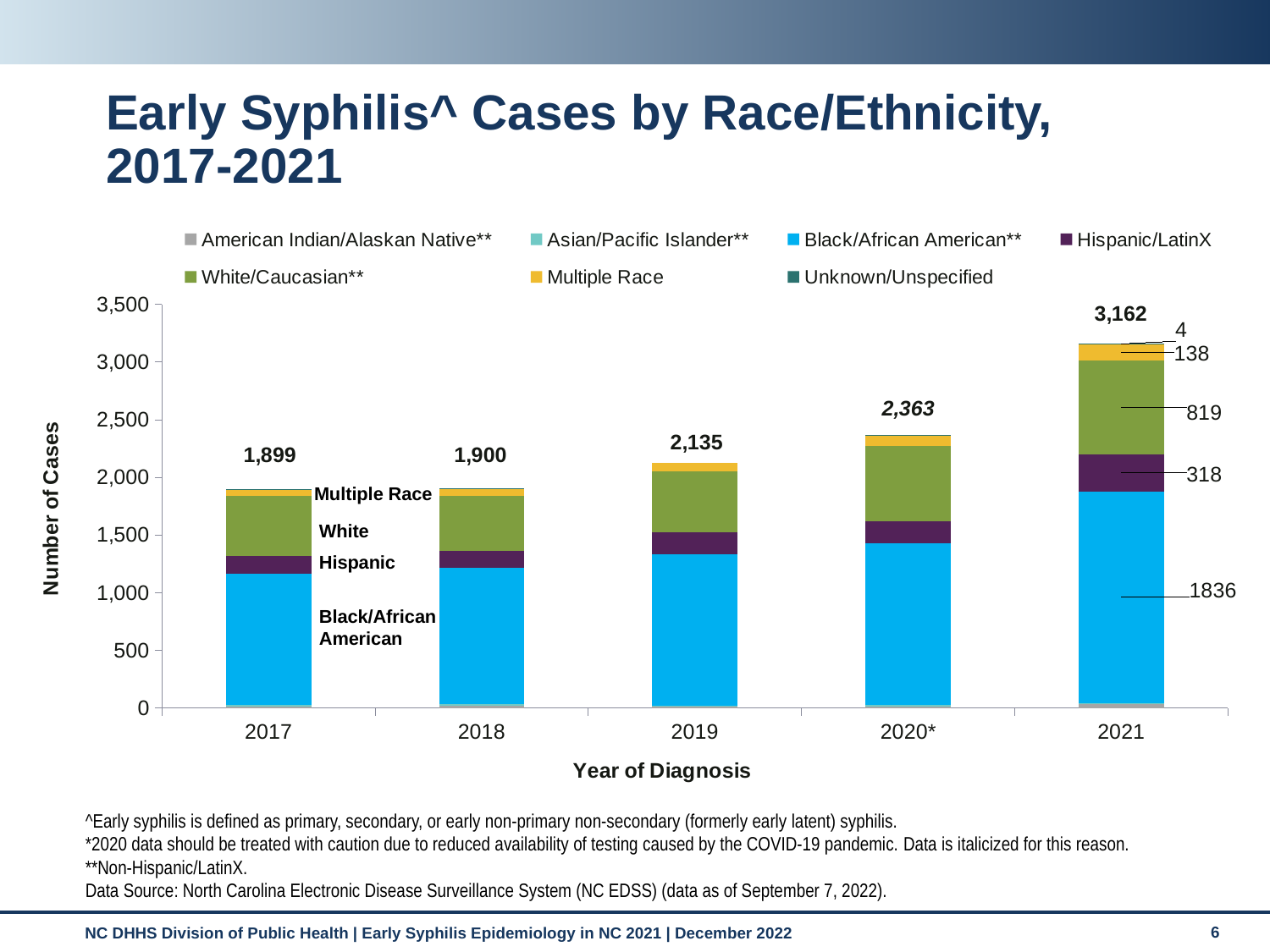
What is the difference between the total cases in 2021 and 2020? 799 How many years are shown on the x axis? 5 How many race/ethnicity series does the legend list? 7 What is the total number of early syphilis cases for 2017? 1,899 Which year has the lowest total number of cases? 2017 Which year has the highest total number of cases? 2021 What kind of chart is shown on the slide? Stacked bar chart How many White/Caucasian cases are labeled for 2021? 819 Is the total number of cases in 2019 greater or less than 2,000? greater What is the total number of early syphilis cases for 2021? 3,162 Do the total cases rise or fall from 2017 to 2021? Rise How many Black/African American cases are labeled for 2021? 1836